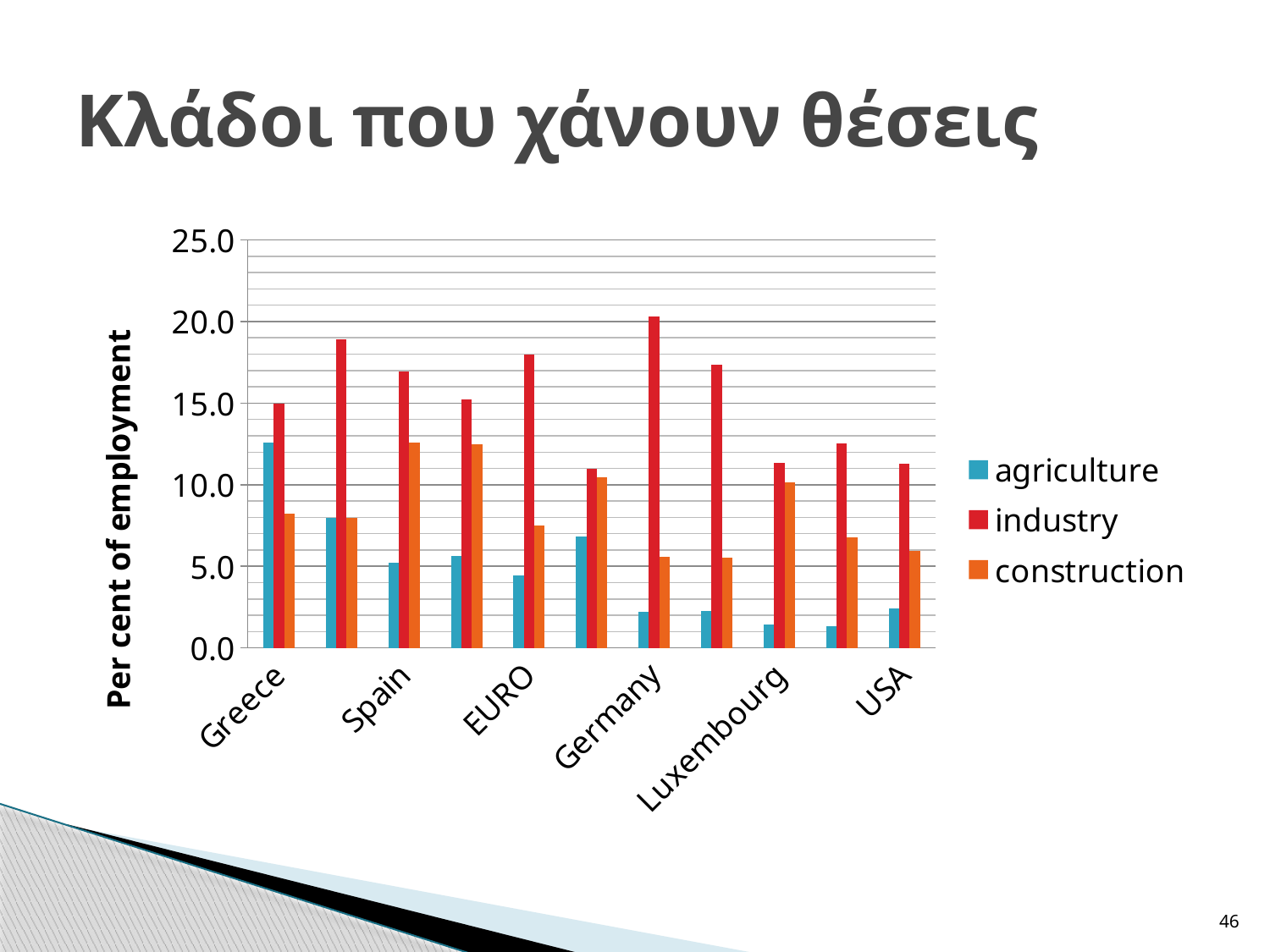
Which has the larger construction value, Spain or Greece? Spain Is the agriculture value for Greece greater or less than 10.0? greater How many series does the legend list? 3 Is the industry value for Germany greater or less than 15.0? greater Is the agriculture value for Luxembourg greater or less than 5.0? less Which has the larger agriculture value, Greece or Spain? Greece What is the title of the vertical axis? Per cent of employment What kind of chart is shown on the slide? bar chart What are the three series named in the legend? agriculture, industry, construction Which has the larger industry value, Germany or Greece? Germany Among the labelled countries, which has the highest industry bar? Germany